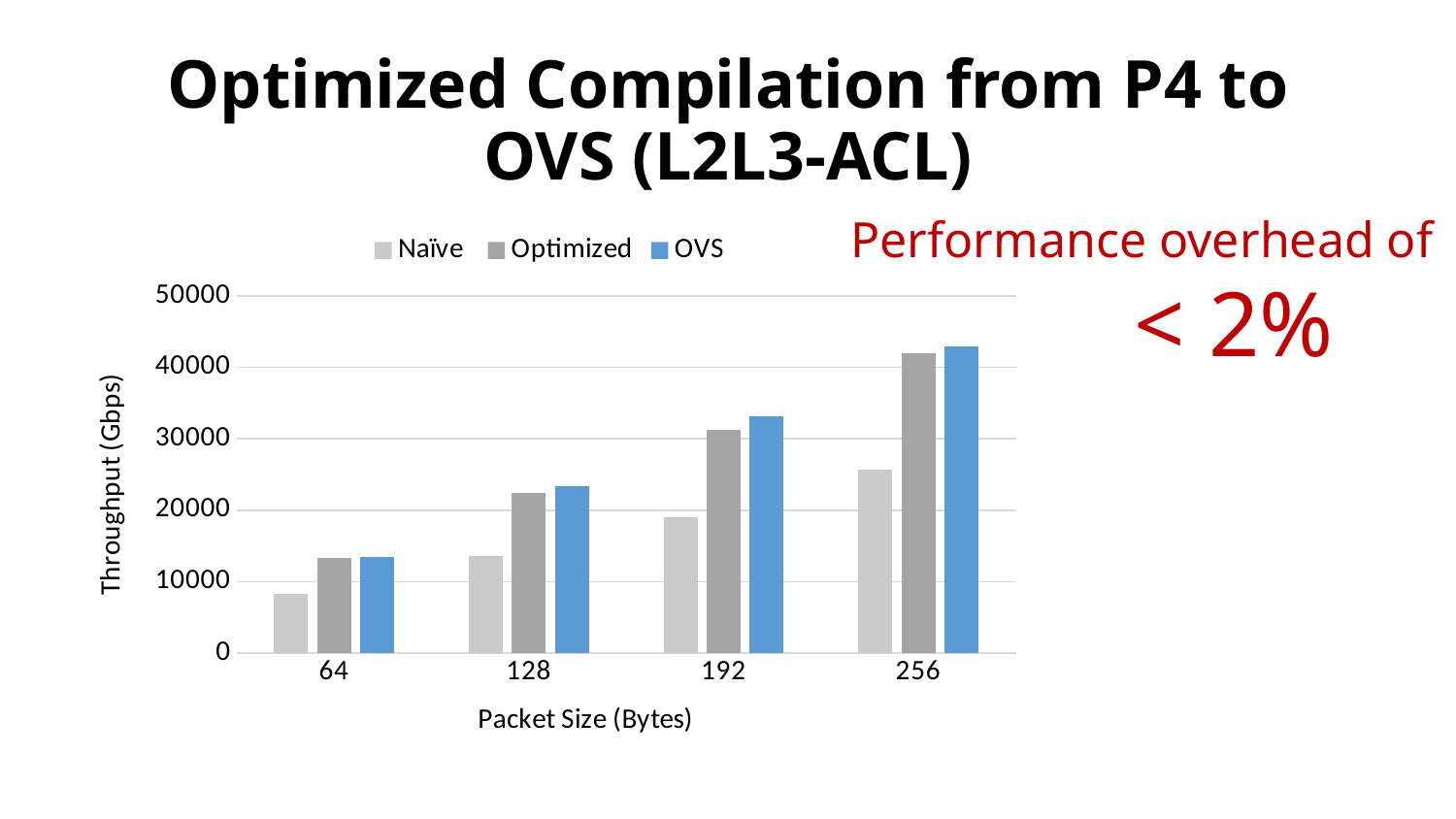
How many series does the legend list? 3 How many packet size categories are shown on the x axis? 4 Does the Optimized throughput rise or fall as packet size increases along the x axis? rise Is the OVS throughput at packet size 256 greater or less than 40000? greater What is the label of the y axis? Throughput (Gbps) What kind of chart is shown on the slide? bar chart Is the Naïve throughput at packet size 64 greater or less than 10000? less Which packet size has the highest OVS throughput? 256 At packet size 256, which is larger: the Naïve throughput or the OVS throughput? OVS Is the Optimized throughput at packet size 128 greater or less than 20000? greater Which packet size has the lowest Naïve throughput? 64